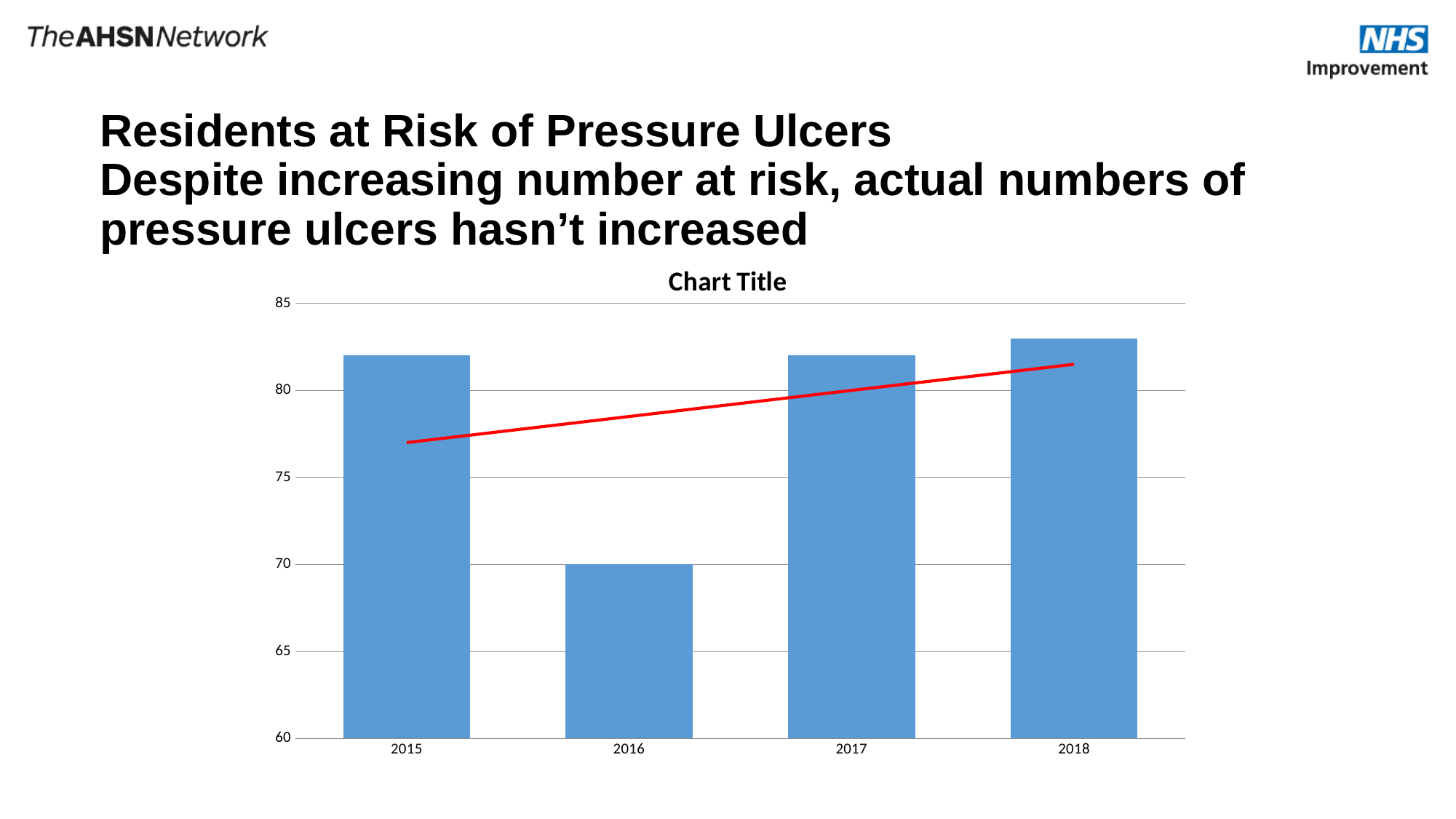
Is the value for 2016 greater or less than 75? less Which year has the lowest bar? 2016 Is the value for 2015 greater or less than 80? greater Which is larger, the value for 2016 or the value for 2018? 2018 What is the value for 2016? 70 Is the value for 2017 greater or less than 75? greater How many years are shown on the x axis? 4 Which is larger, the value for 2015 or the value for 2016? 2015 What kind of chart is shown on the slide? bar chart What is the title printed above the chart? Chart Title Does the red trend line rise or fall from 2015 to 2018? rise